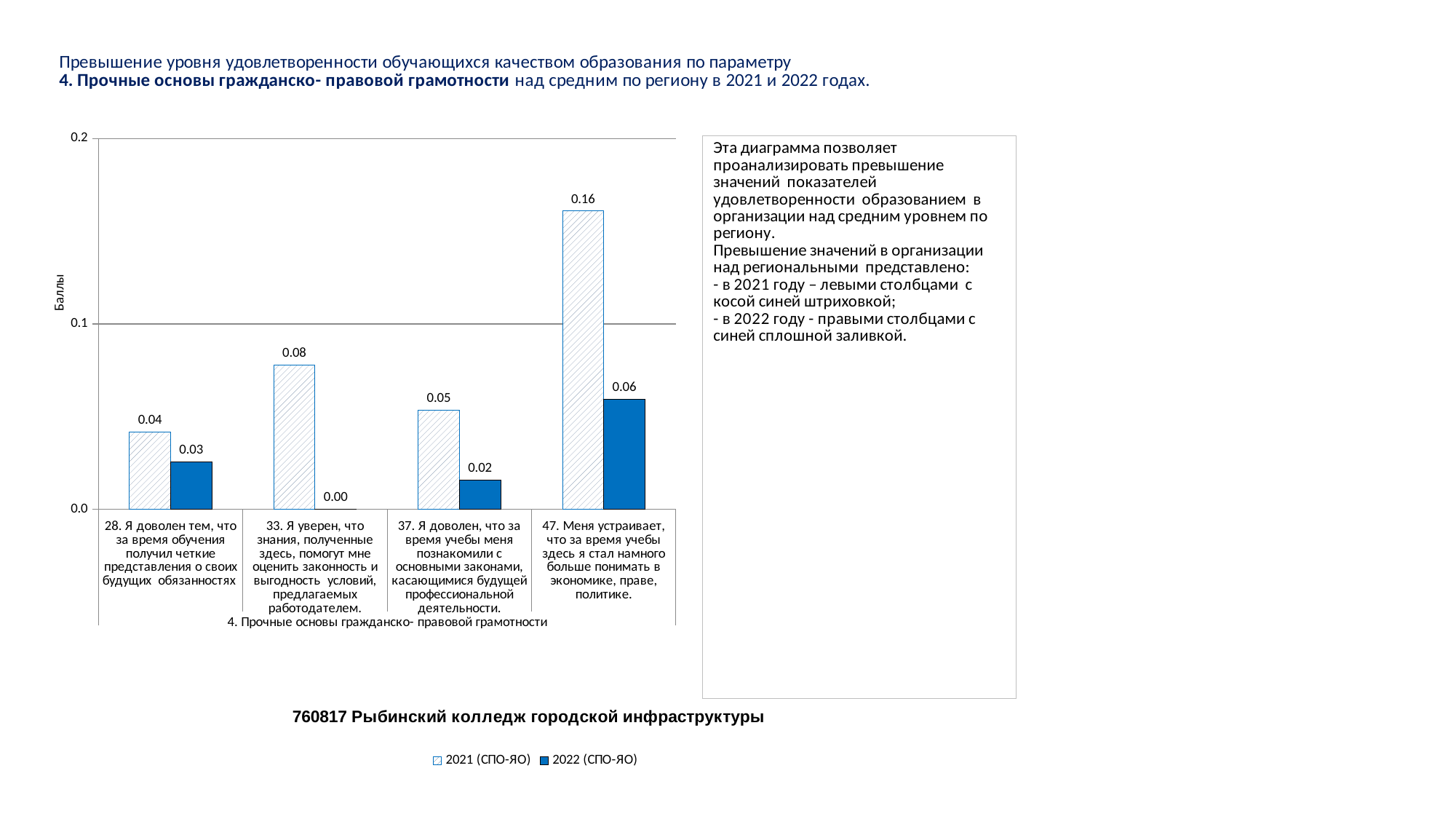
What is the 2021 (СПО-ЯО) value for question 47 (Меня устраивает, что за время учебы здесь я стал намного больше понимать в экономике, праве, политике)? 0.16 What is the difference between the 2021 and 2022 values for question 47? 0.10 Which category has the highest 2021 (СПО-ЯО) value? 47. Меня устраивает, что за время учебы здесь я стал намного больше понимать в экономике, праве, политике. For question 37, which series has the larger value, 2021 (СПО-ЯО) or 2022 (СПО-ЯО)? 2021 (СПО-ЯО) Is the 2021 (СПО-ЯО) value for question 47 greater or less than 0.1? greater How many categories (questions) are shown on the x axis? 4 What type of chart is shown on the slide? bar chart What is the 2022 (СПО-ЯО) value for question 28? 0.03 What is the label of the y axis? Баллы Which category has the lowest 2022 (СПО-ЯО) value? 33. Я уверен, что знания, полученные здесь, помогут мне оценить законность и выгодность условий, предлагаемых работодателем. How many series does the legend list? 2 What is the 2022 (СПО-ЯО) value for question 33 (Я уверен, что знания, полученные здесь, помогут мне оценить законность и выгодность условий, предлагаемых работодателем)? 0.00